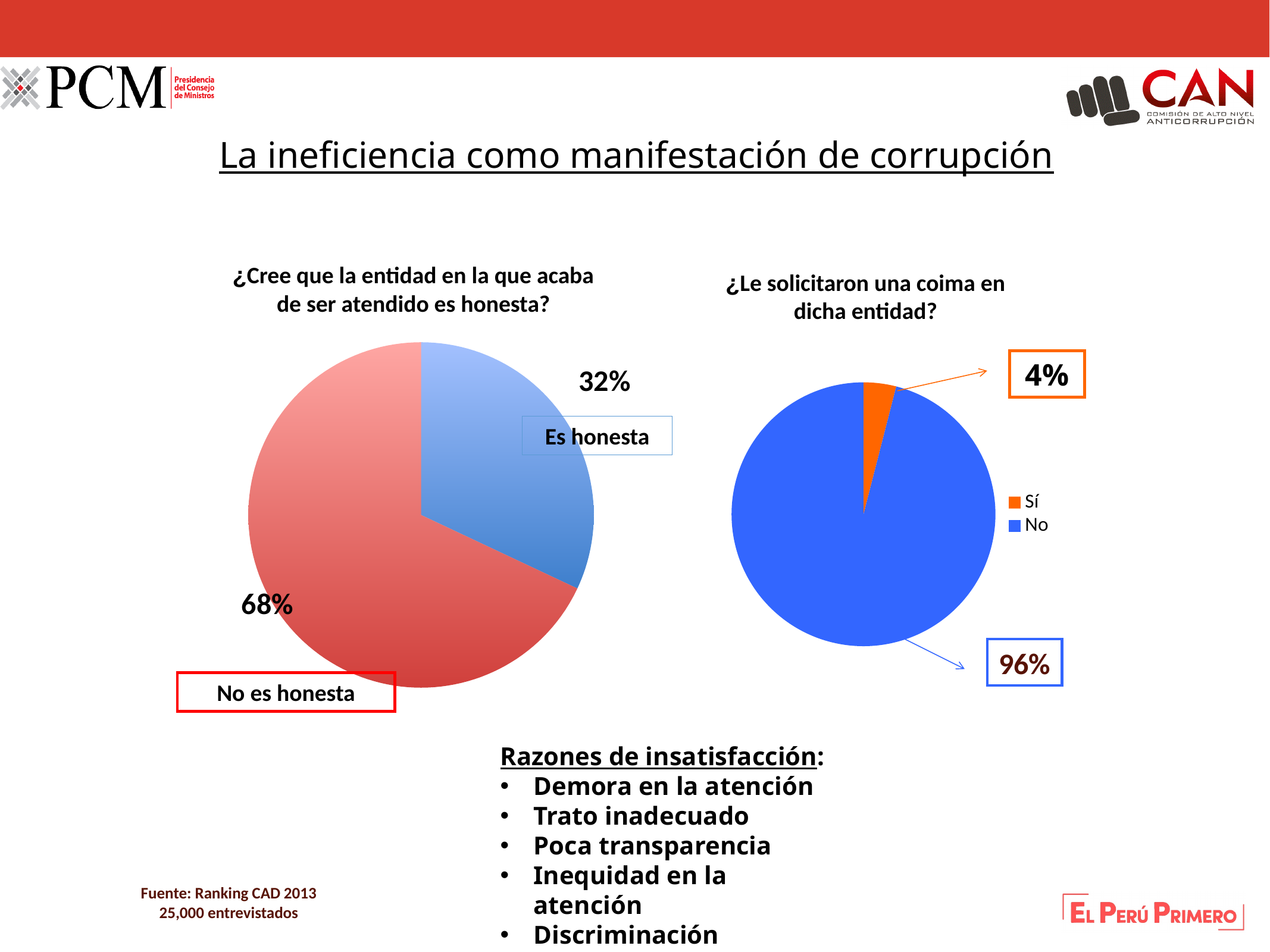
In the right pie chart (¿Le solicitaron una coima en dicha entidad?), what share of respondents answered 'Sí'? 4% In the right pie chart (¿Le solicitaron una coima en dicha entidad?), what is the difference in percentage points between 'No' and 'Sí'? 92 percentage points In the right pie chart (¿Le solicitaron una coima en dicha entidad?), what colour is the 'Sí' slice? Orange In the right pie chart (¿Le solicitaron una coima en dicha entidad?), which response has the smaller share? Sí In the right pie chart (¿Le solicitaron una coima en dicha entidad?), how many entries does the legend list? 2 In the right pie chart (¿Le solicitaron una coima en dicha entidad?), what share of respondents answered 'No'? 96% In the left pie chart (¿Cree que la entidad en la que acaba de ser atendido es honesta?), what share of respondents answered 'Es honesta'? 32% In the left pie chart (¿Cree que la entidad en la que acaba de ser atendido es honesta?), which response has the larger share? No es honesta What type of chart is used for ¿Le solicitaron una coima en dicha entidad? Pie chart How many slices does the left pie chart (¿Cree que la entidad en la que acaba de ser atendido es honesta?) have? 2 In the left pie chart (¿Cree que la entidad en la que acaba de ser atendido es honesta?), what share of respondents answered 'No es honesta'? 68% In the left pie chart (¿Cree que la entidad en la que acaba de ser atendido es honesta?), what is the difference in percentage points between 'No es honesta' and 'Es honesta'? 36 percentage points